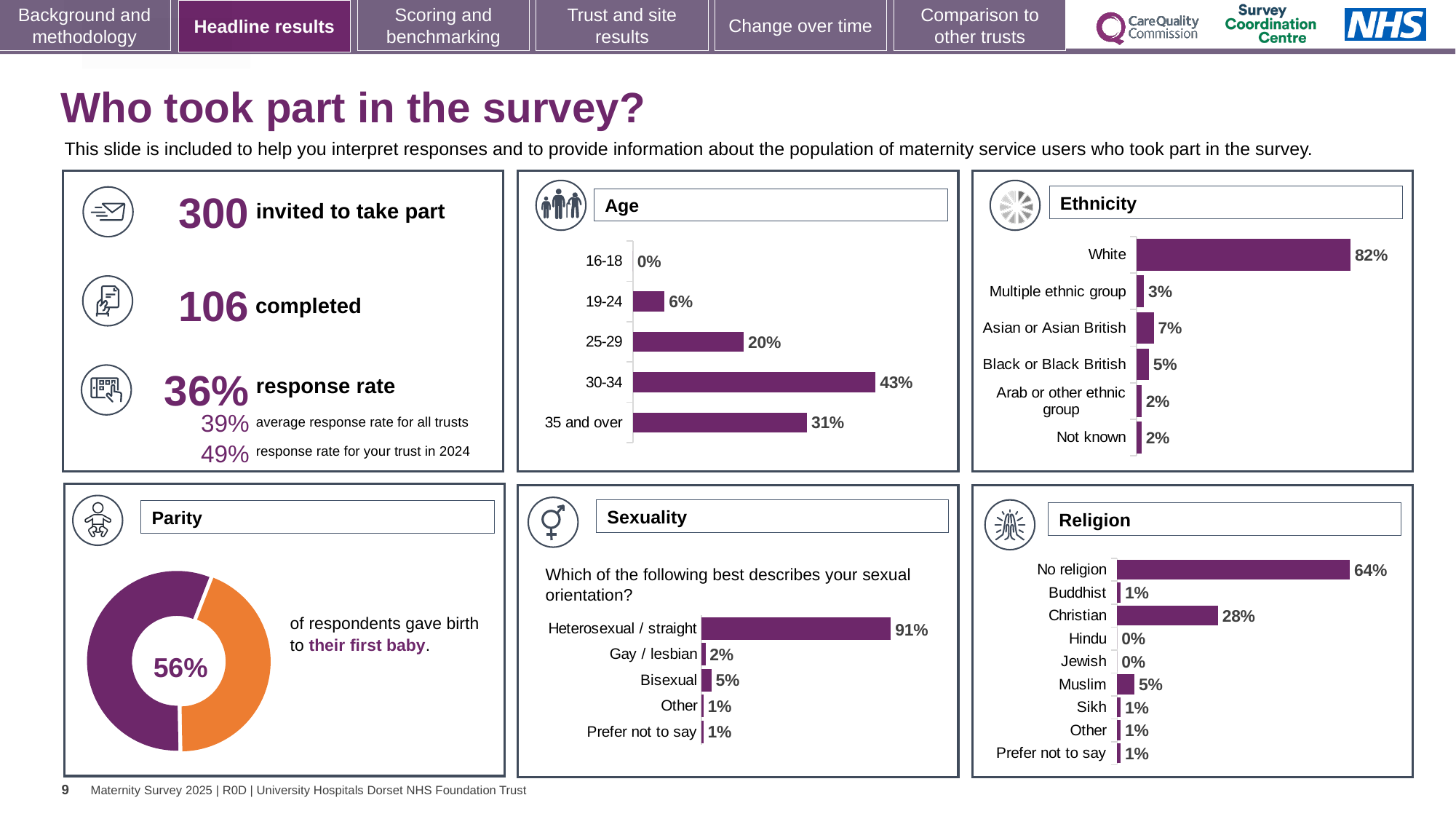
In the Age chart, what percentage of respondents were aged 30-34? 43% In the Ethnicity chart, how many ethnic categories are shown? 6 In the Sexuality chart, how many categories are shown? 5 In the Sexuality chart, what percentage of respondents described themselves as Bisexual? 5% In the Religion chart, what is the difference between No religion and Christian? 36% In the Ethnicity chart, what percentage of respondents were White? 82% In the Age chart, what is the difference between the 30-34 and 35 and over percentages? 12% In the Ethnicity chart, which is larger, Asian or Asian British or Black or Black British? Asian or Asian British In the Age chart, which age group has the highest percentage? 30-34 In the Religion chart, what percentage of respondents were Christian? 28% In the Parity chart, what percentage of respondents gave birth to their first baby? 56% What kind of chart is the Parity chart? Doughnut chart